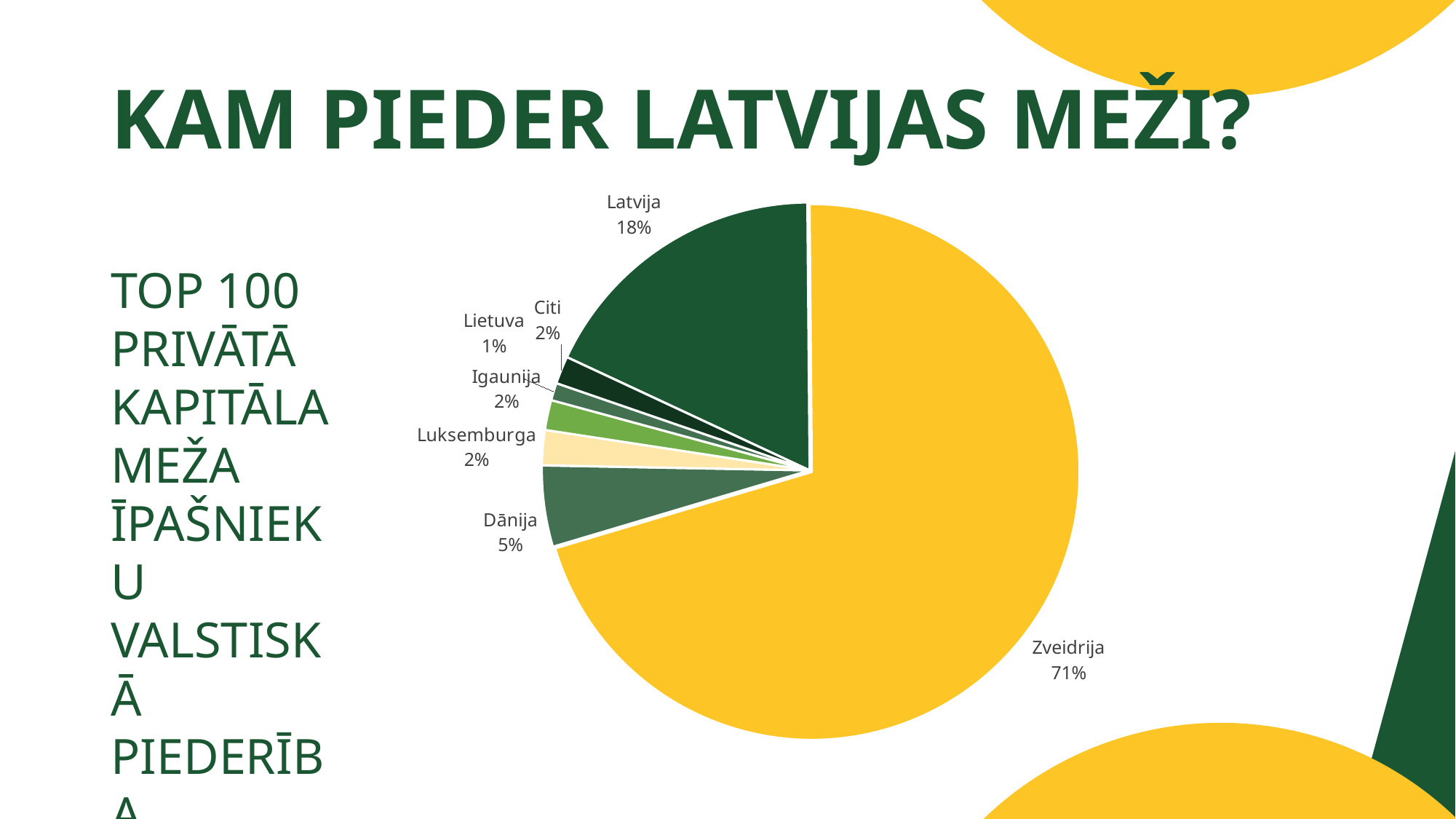
Which category has the smallest slice of the pie? Lietuva Which is larger, the share for Dānija or the share for Luksemburga? Dānija What is the difference between the shares of Zveidrija and Latvija? 53% What colour is the Zveidrija slice? Yellow How many slices does the pie chart have? 7 Which category has the largest slice of the pie? Zveidrija What is the value shown for Latvija? 18% What share of the pie does Zveidrija hold? 71% What percentage is shown for Dānija? 5% What kind of chart is shown on the slide? Pie chart What is the combined share of Igaunija and Citi? 4% What is the value shown for Lietuva? 1%